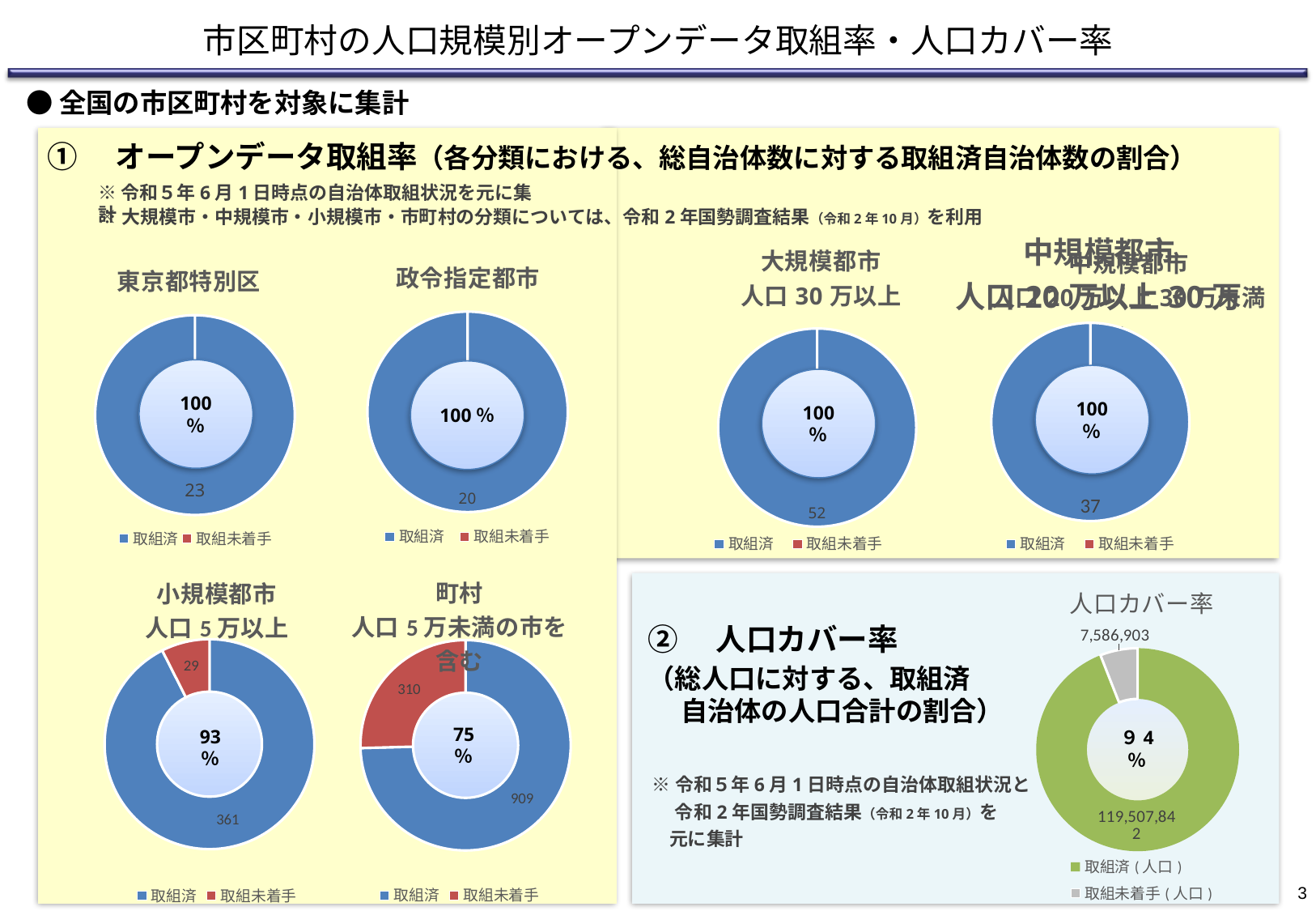
In the 町村 chart, what is the value for 取組済? 909 In the 人口カバー率 chart, what is the value for 取組済（人口）? 119,507,842 In the 小規模都市 人口5万以上 chart, what is the total of 取組済 and 取組未着手? 390 In the 町村 chart, what is the difference between 取組済 and 取組未着手? 599 In the 大規模都市 人口30万以上 chart, what is the value for 取組済? 52 In the 町村 chart, what is the value for 取組未着手? 310 In the 人口カバー率 chart, what is the value for 取組未着手（人口）? 7,586,903 In the 東京都特別区 chart, what is the value for 取組済? 23 In the 小規模都市 人口5万以上 chart, what is the value for 取組未着手? 29 In the 政令指定都市 chart, what is the value for 取組済? 20 In the 町村 chart, which is larger, 取組済 or 取組未着手? 取組済 How many series does the legend of the 人口カバー率 chart list? 2